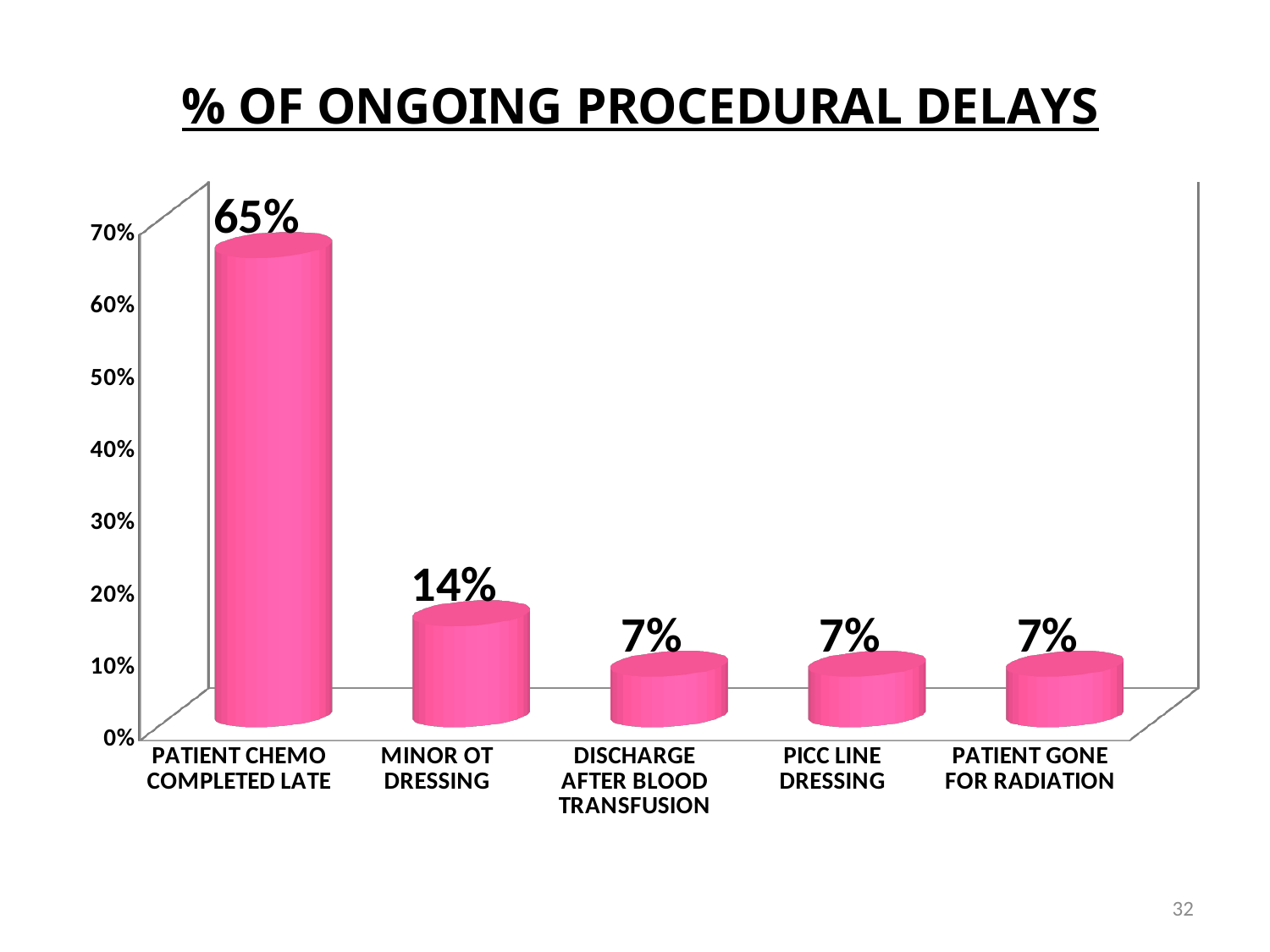
Is the value for PATIENT CHEMO COMPLETED LATE greater or less than 60%? greater What is the value for MINOR OT DRESSING? 14% Which is larger, the value for MINOR OT DRESSING or the value for PATIENT GONE FOR RADIATION? MINOR OT DRESSING What is the value for PATIENT CHEMO COMPLETED LATE? 65% What is the value for DISCHARGE AFTER BLOOD TRANSFUSION? 7% Which category has the highest value? PATIENT CHEMO COMPLETED LATE What is the difference between the values for PATIENT CHEMO COMPLETED LATE and MINOR OT DRESSING? 51% What kind of chart is shown on the slide? bar chart How many categories are shown on the x axis? 5 What is the title of the chart? % OF ONGOING PROCEDURAL DELAYS What is the value for PICC LINE DRESSING? 7% What is the difference between the values for MINOR OT DRESSING and PICC LINE DRESSING? 7%